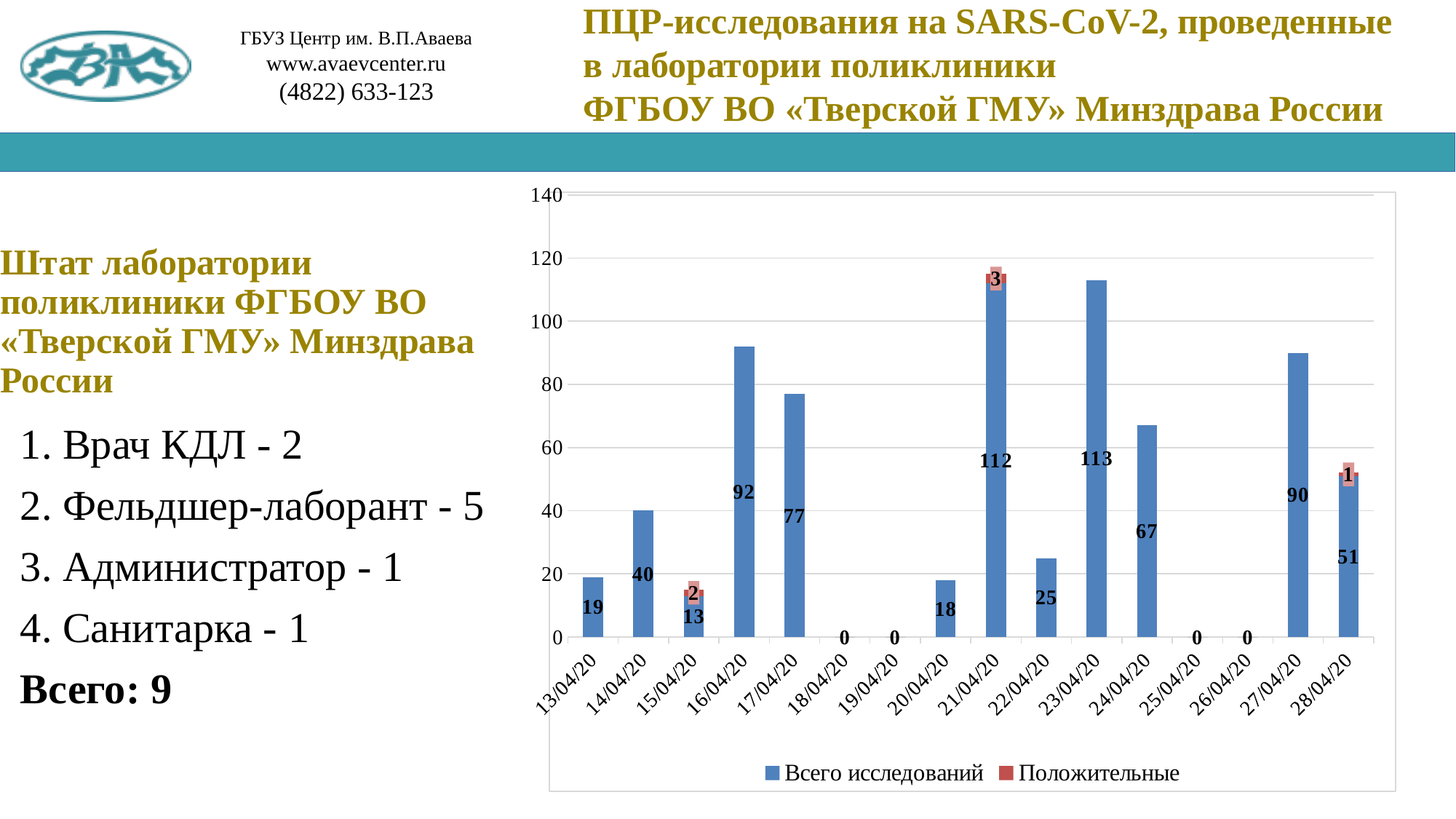
What is the value of "Всего исследований" for 24/04/20? 67 How many dates on the chart have a "Всего исследований" value of 0? 4 How many dates are shown on the x axis of the chart? 16 Which is larger, the "Всего исследований" value for 14/04/20 or for 22/04/20? 14/04/20 What is the value of "Всего исследований" for 16/04/20? 92 On which date is the "Всего исследований" value the highest? 23/04/20 How many series does the chart legend list? 2 What is the value of "Положительные" for 21/04/20? 3 What type of chart is shown on the slide? bar chart What is the value of "Положительные" for 15/04/20? 2 What is the difference between the "Всего исследований" values for 27/04/20 and 28/04/20? 39 What is the total of the stacked bar for 28/04/20? 52